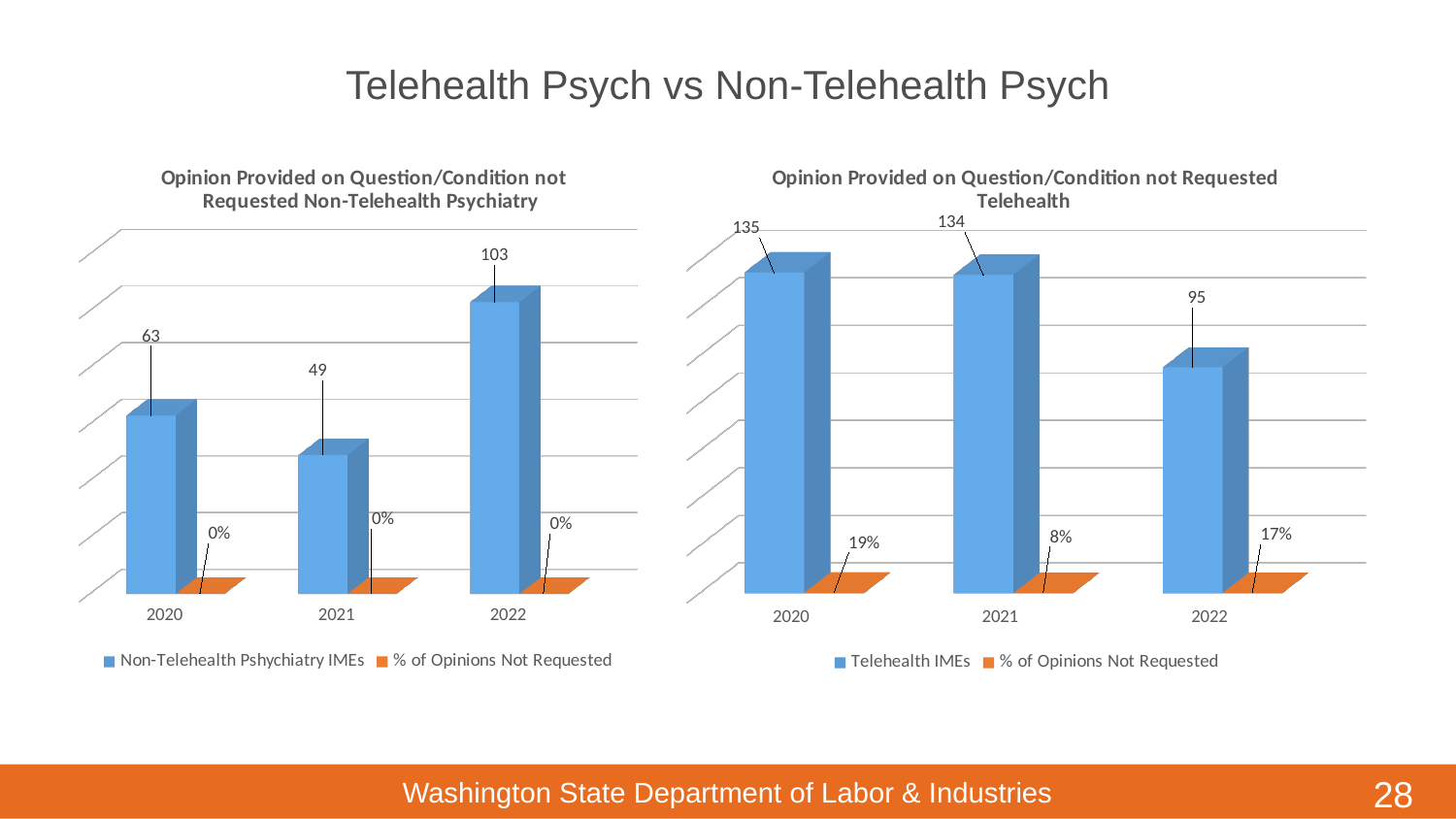
In the right chart (Telehealth), what is the value for Telehealth IMEs in 2020? 135 What kind of chart is the right chart (Telehealth)? Bar chart How many series does the legend of the left chart (Non-Telehealth Psychiatry) list? 2 In the right chart (Telehealth), what is the % of Opinions Not Requested in 2021? 8% In the left chart (Non-Telehealth Psychiatry), what is the value for Non-Telehealth Pshychiatry IMEs in 2021? 49 In the left chart (Non-Telehealth Psychiatry), what is the value for Non-Telehealth Pshychiatry IMEs in 2022? 103 Which is larger: Telehealth IMEs in 2022 in the right chart, or Non-Telehealth Pshychiatry IMEs in 2020 in the left chart? Telehealth IMEs in 2022 In the right chart (Telehealth), what is the difference between the % of Opinions Not Requested in 2020 and 2021? 11% In the right chart (Telehealth), which year has the lowest number of Telehealth IMEs? 2022 How many years are shown on the x axis of the right chart (Telehealth)? 3 In the left chart (Non-Telehealth Psychiatry), what is the difference between the IMEs in 2022 and 2020? 40 In the left chart (Non-Telehealth Psychiatry), which year has the highest number of Non-Telehealth Pshychiatry IMEs? 2022